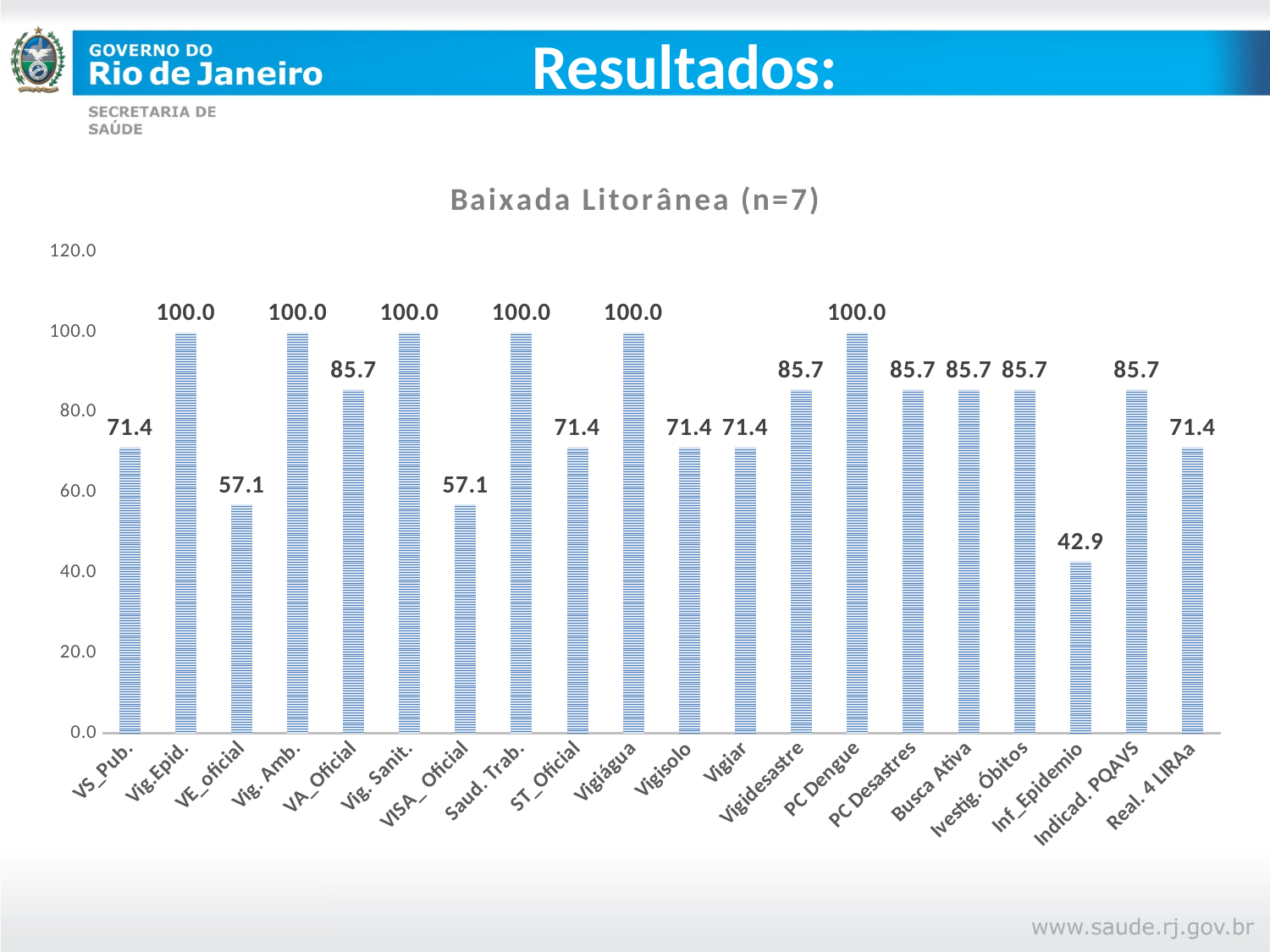
What is the value for Inf_Epidemio? 42.9 What is the title of the chart? Baixada Litorânea (n=7) What is the value for VE_oficial? 57.1 Which category has the lowest value? Inf_Epidemio What is the highest value shown on the chart? 100.0 Is the value for VISA_ Oficial greater or less than 60.0? less What is the value for PC Dengue? 100.0 What is the difference between the values for VA_Oficial and Inf_Epidemio? 42.8 What is the value for Indicad. PQAVS? 85.7 What is the difference between the values for Vig.Epid. and VE_oficial? 42.9 Which is larger, the value for Vigidesastre or the value for Vigisolo? Vigidesastre How many categories are shown on the chart? 20